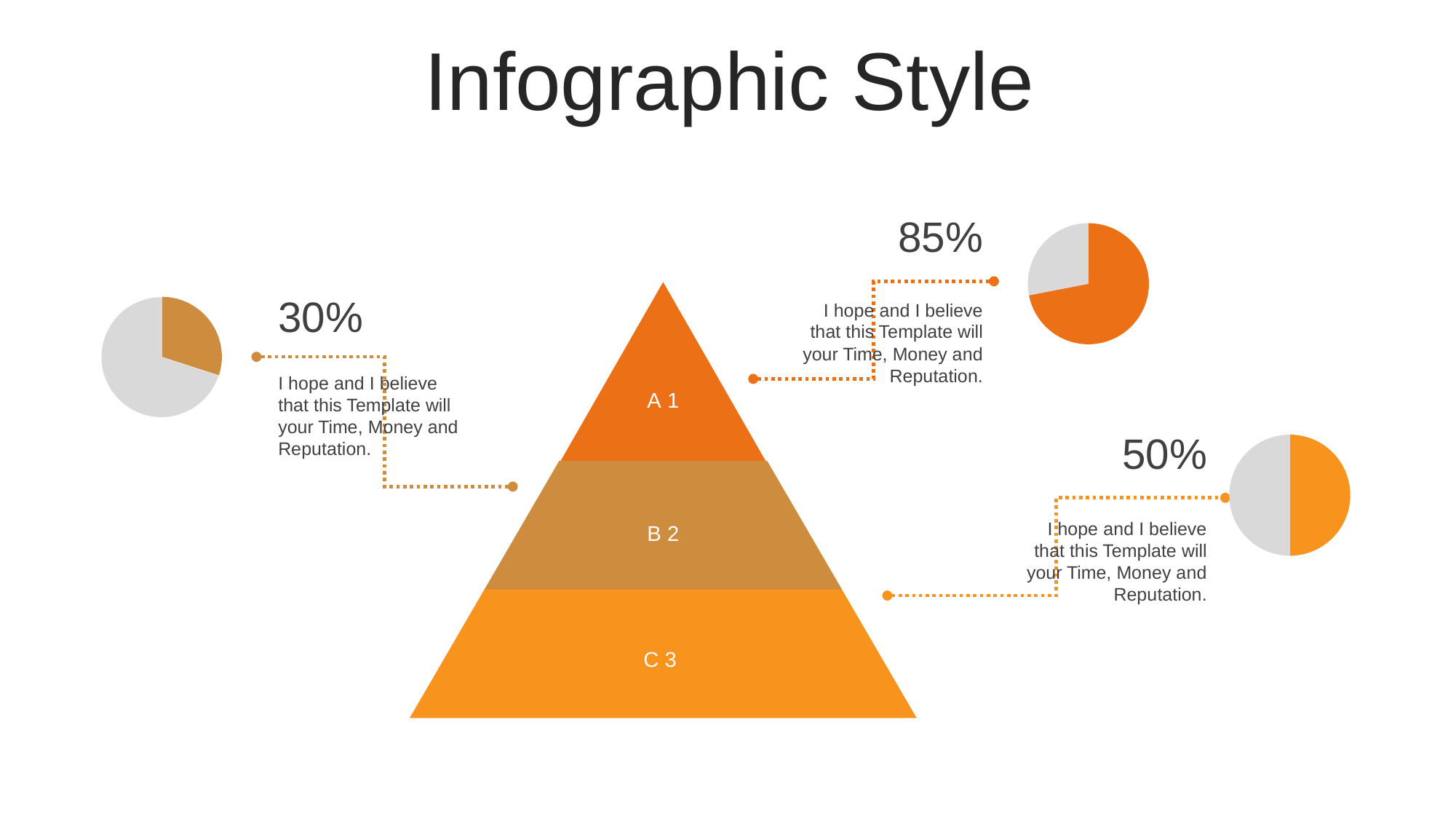
How many segments does the pyramid in the centre of the slide have? 3 What is the label of the bottom segment of the pyramid? C 3 What is the label of the top segment of the pyramid? A 1 What percentage is shown next to the pie chart in the top-right of the slide? 85% What kind of chart are the three small circular charts on the slide? pie chart How many small pie charts are on the slide? 3 Of the three pie charts on the slide, which position (left, top-right or bottom-right) shows the highest percentage? top-right What percentage is shown next to the pie chart in the bottom-right of the slide? 50% What percentage is shown next to the pie chart on the left side of the slide? 30% Of the three pie charts on the slide, which position (left, top-right or bottom-right) shows the lowest percentage? left Which is larger: the percentage shown for the bottom-right pie chart or the percentage shown for the left pie chart? bottom-right pie chart What is the difference between the percentage shown for the top-right pie chart and the percentage shown for the left pie chart? 55%